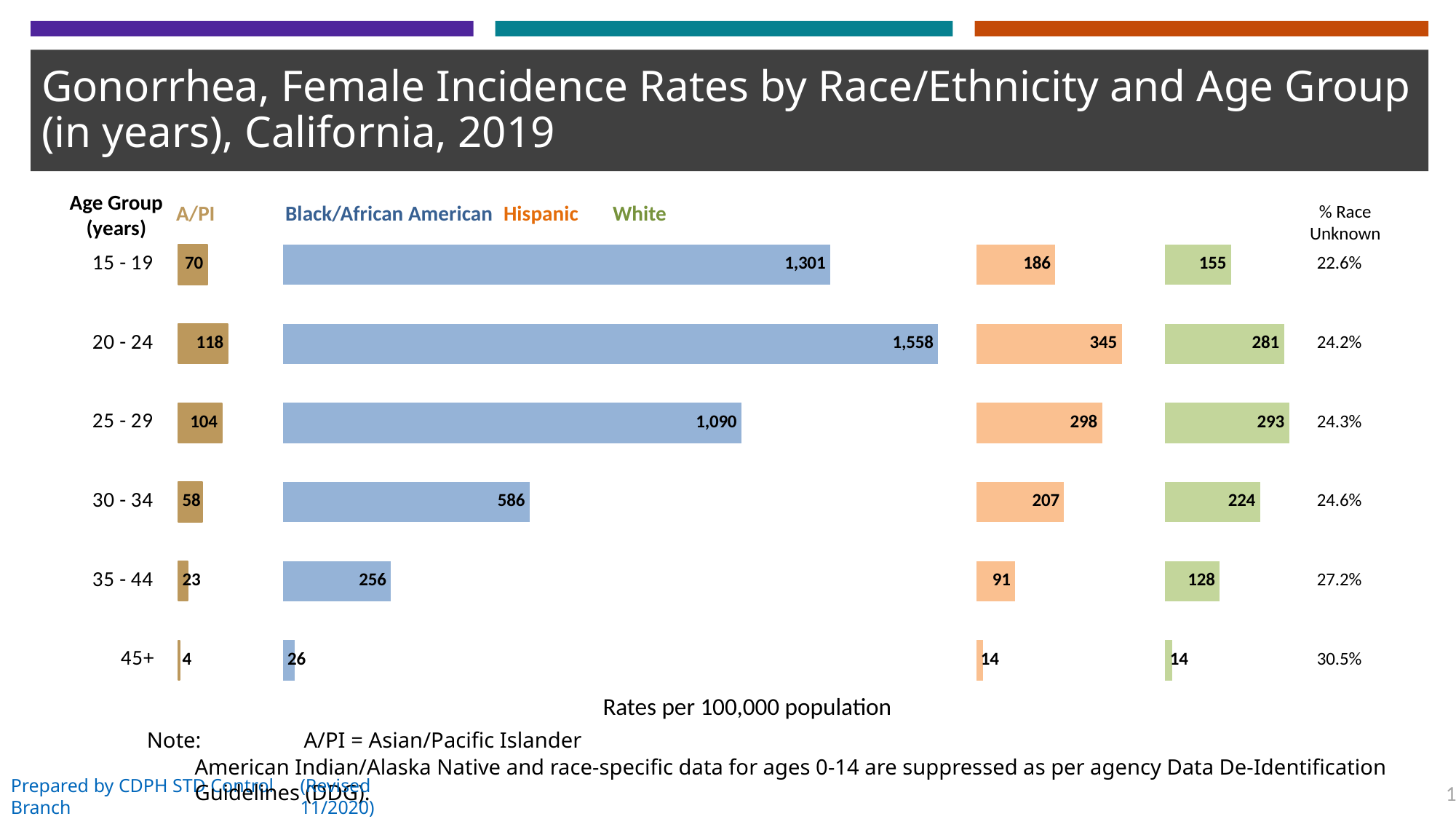
What kind of chart is shown on the slide? Bar chart How many age groups are shown in the chart? 6 What is the rate for A/PI females aged 30 - 34? 58 Which age group has the lowest rate among Hispanic females? 45+ What is the difference between the Black/African American rates for ages 15 - 19 and 25 - 29? 211 Which is larger for ages 30 - 34: the Hispanic rate or the White rate? White What is the rate for Hispanic females aged 25 - 29? 298 What is the gonorrhea incidence rate for Black/African American females aged 20 - 24? 1,558 What is the rate for White females aged 35 - 44? 128 How many race/ethnicity series are shown in the chart? 4 Which age group has the highest rate among Black/African American females? 20 - 24 What is the % Race Unknown value for the 45+ age group? 30.5%